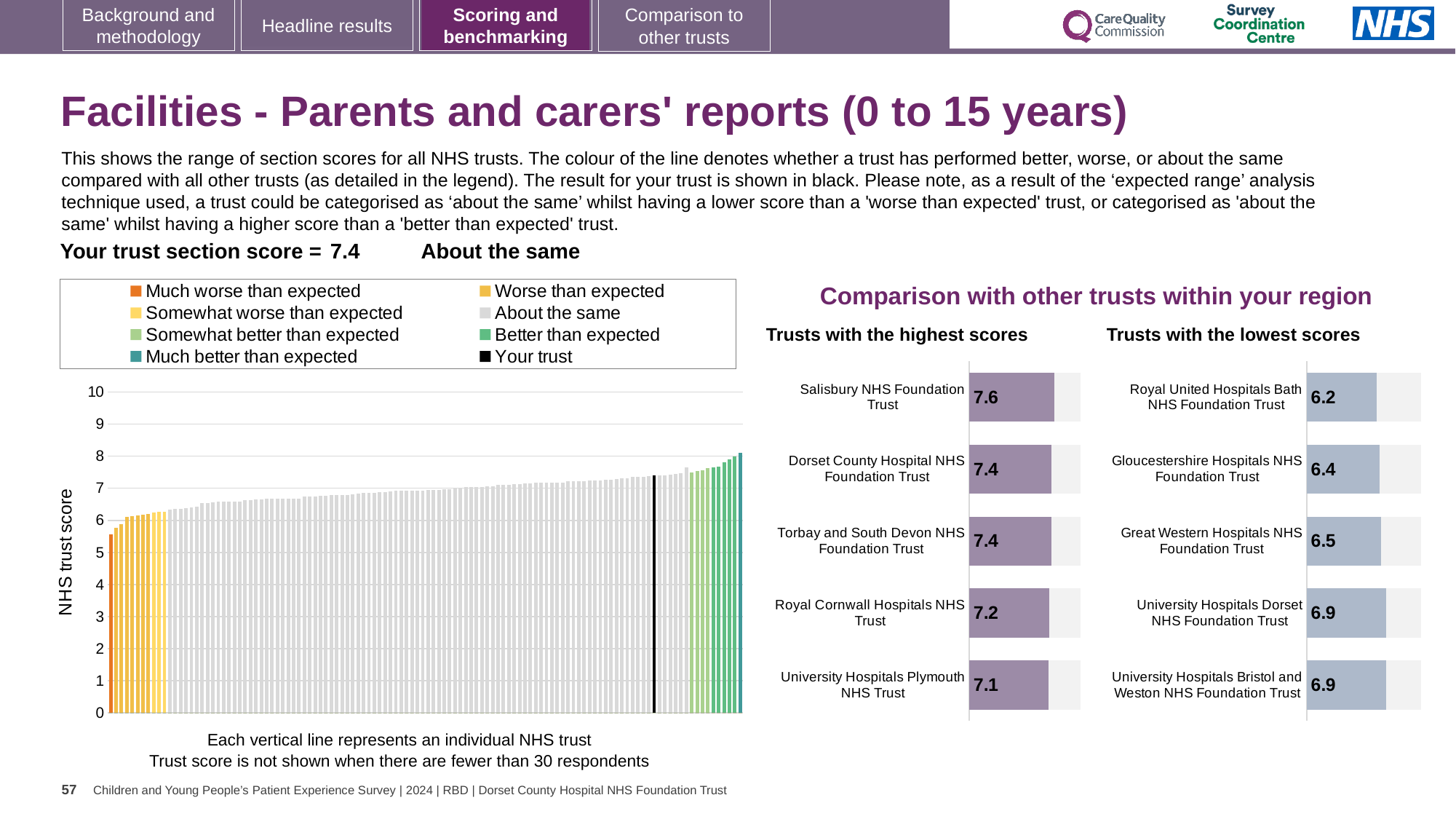
How many entries does the legend above the main chart on the left list? 8 In the 'Trusts with the lowest scores' chart, what is the score for University Hospitals Dorset NHS Foundation Trust? 6.9 In the main chart on the left, do the trust scores rise or fall from left to right? Rise In the 'Trusts with the lowest scores' chart, what is the score for Royal United Hospitals Bath NHS Foundation Trust? 6.2 In the main chart on the left showing all NHS trusts, what is the section score for your trust (the black line)? 7.4 In the 'Trusts with the highest scores' chart, what is the score for Salisbury NHS Foundation Trust? 7.6 In the 'Trusts with the highest scores' chart, what is the difference between the scores of Salisbury NHS Foundation Trust and Royal Cornwall Hospitals NHS Trust? 0.4 In the 'Trusts with the highest scores' chart, which trust has the lowest score? University Hospitals Plymouth NHS Trust In the 'Trusts with the lowest scores' chart, which trust has the lowest score? Royal United Hospitals Bath NHS Foundation Trust What kind of chart is the main chart on the left showing all NHS trusts? Bar chart How many trusts are shown in the 'Trusts with the highest scores' chart? 5 In the 'Trusts with the lowest scores' chart, which has the higher score: Gloucestershire Hospitals NHS Foundation Trust or Great Western Hospitals NHS Foundation Trust? Great Western Hospitals NHS Foundation Trust